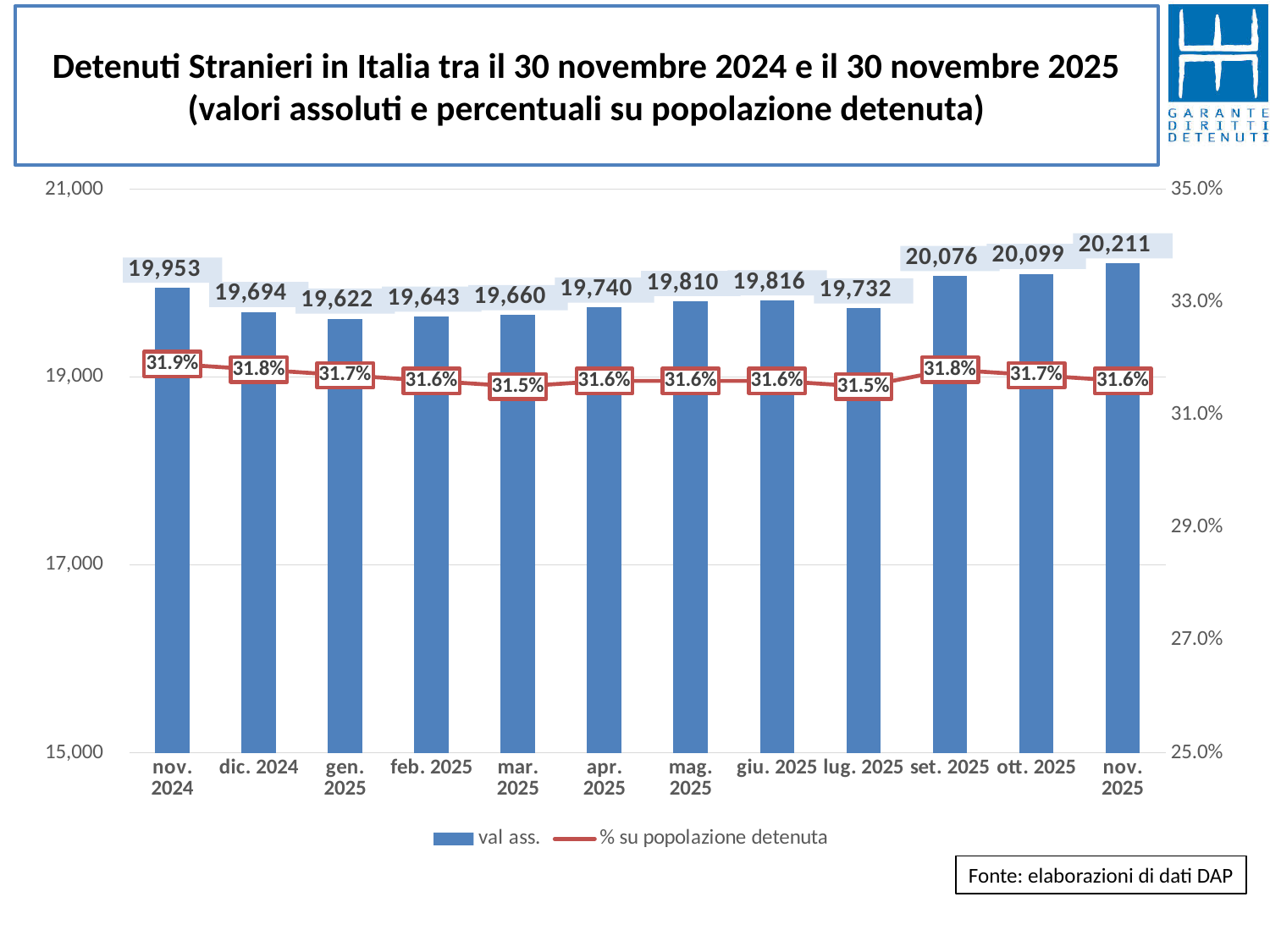
What is the source cited on the slide? Fonte: elaborazioni di dati DAP How many series does the legend list? 2 Which month has the lowest 'val ass.' value? gen. 2025 Is the 'val ass.' value for mar. 2025 greater or less than 19,000? greater What is the '% su popolazione detenuta' value for nov. 2024? 31.9% What is the difference in 'val ass.' between nov. 2025 and nov. 2024? 258 What kind of chart is used for the 'val ass.' series? bar chart What is the 'val ass.' value for nov. 2025? 20,211 Which month has the highest 'val ass.' value? nov. 2025 Which is larger, the 'val ass.' value for set. 2025 or for ott. 2025? ott. 2025 What is the 'val ass.' value for gen. 2025? 19,622 How many months are shown on the x axis? 12